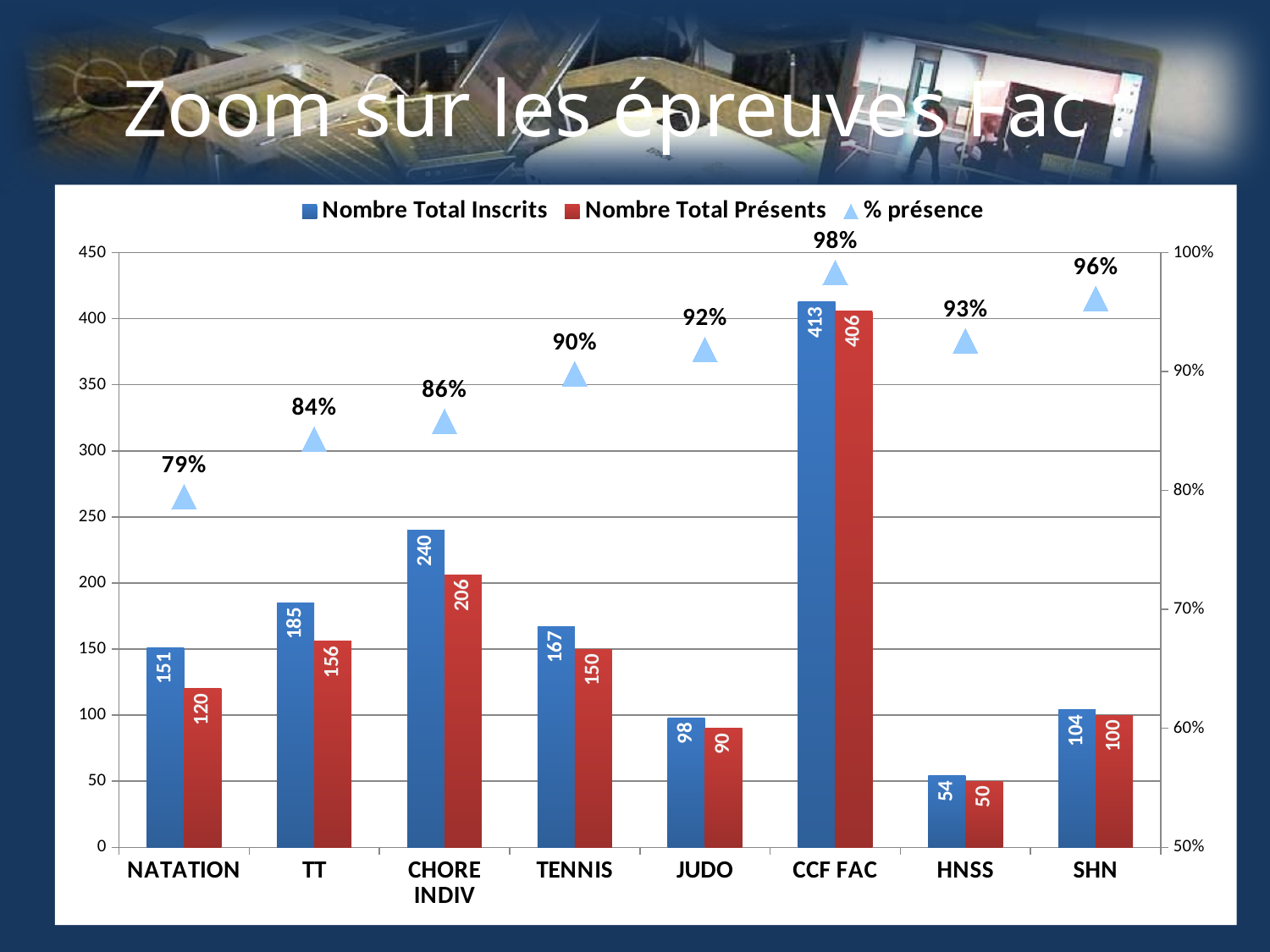
What is the Nombre Total Inscrits value for CHORE INDIV? 240 Which is larger: the Nombre Total Présents for TT or for SHN? TT What is the difference between Nombre Total Inscrits and Nombre Total Présents for NATATION? 31 What is the % présence value for NATATION? 79% How many series does the legend list? 3 Which category has the highest Nombre Total Inscrits? CCF FAC What is the Nombre Total Présents value for TENNIS? 150 Which category has the lowest % présence? NATATION What colour are the Nombre Total Présents bars? red How many categories are shown on the x axis? 8 What kind of chart is used for the Nombre Total Inscrits and Nombre Total Présents series? bar chart Is the Nombre Total Inscrits value for JUDO greater or less than 100? less